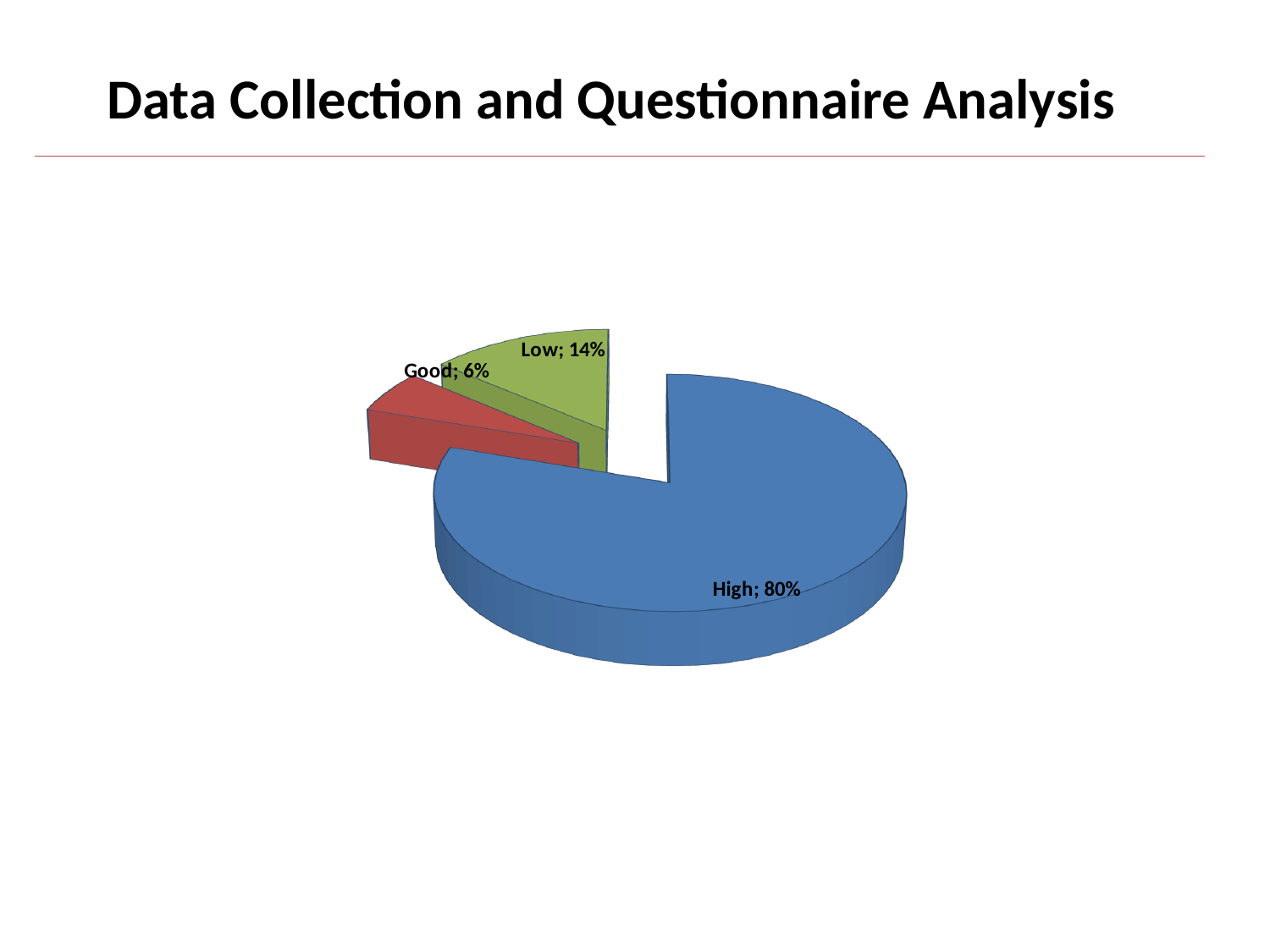
How many slices does the pie chart have? 3 Which category has the smallest share of the pie? Good What colour is the High slice? Blue Which is larger, the Low slice or the Good slice? Low What kind of chart is shown on the slide? Pie chart What is the difference in percentage points between the High and Low slices? 66 What is the difference in percentage points between the Low and Good slices? 8 What percentage does the High slice represent? 80% What percentage does the Low slice represent? 14% Which category has the largest share of the pie? High What is the title of the slide containing the chart? Data Collection and Questionnaire Analysis What percentage does the Good slice represent? 6%